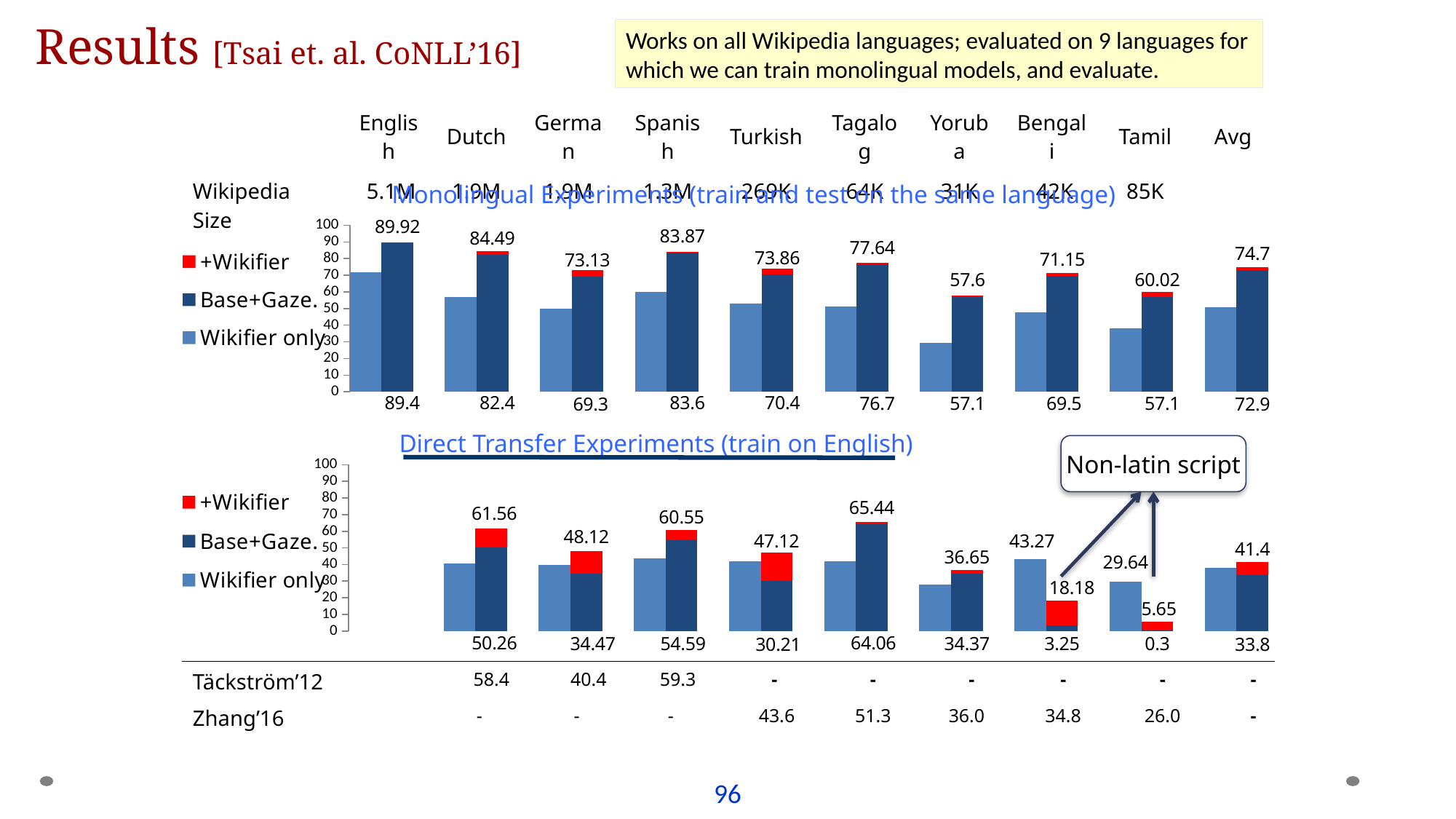
In the Monolingual Experiments chart, what is the +Wikifier value for Avg? 74.7 In the Monolingual Experiments chart, is the Wikifier only value for Yoruba greater or less than 40? less In the Monolingual Experiments chart, what is the Base+Gaze. value for Spanish? 83.6 In the Monolingual Experiments chart, which is larger for Turkish: the +Wikifier value or the Base+Gaze. value? +Wikifier How many series does the legend of the Direct Transfer Experiments chart list? 3 In the Direct Transfer Experiments chart, what is the Base+Gaze. value for Tamil? 0.3 In the Monolingual Experiments chart, what is the +Wikifier value for English? 89.92 In the Direct Transfer Experiments chart, what is the difference between the +Wikifier and Base+Gaze. values for Dutch? 11.3 In the Monolingual Experiments chart, which language has the highest +Wikifier value? English In the Direct Transfer Experiments chart, which language has the lowest +Wikifier value? Tamil In the Direct Transfer Experiments chart, what is the +Wikifier value for Tagalog? 65.44 What type of chart is the Monolingual Experiments chart? bar chart